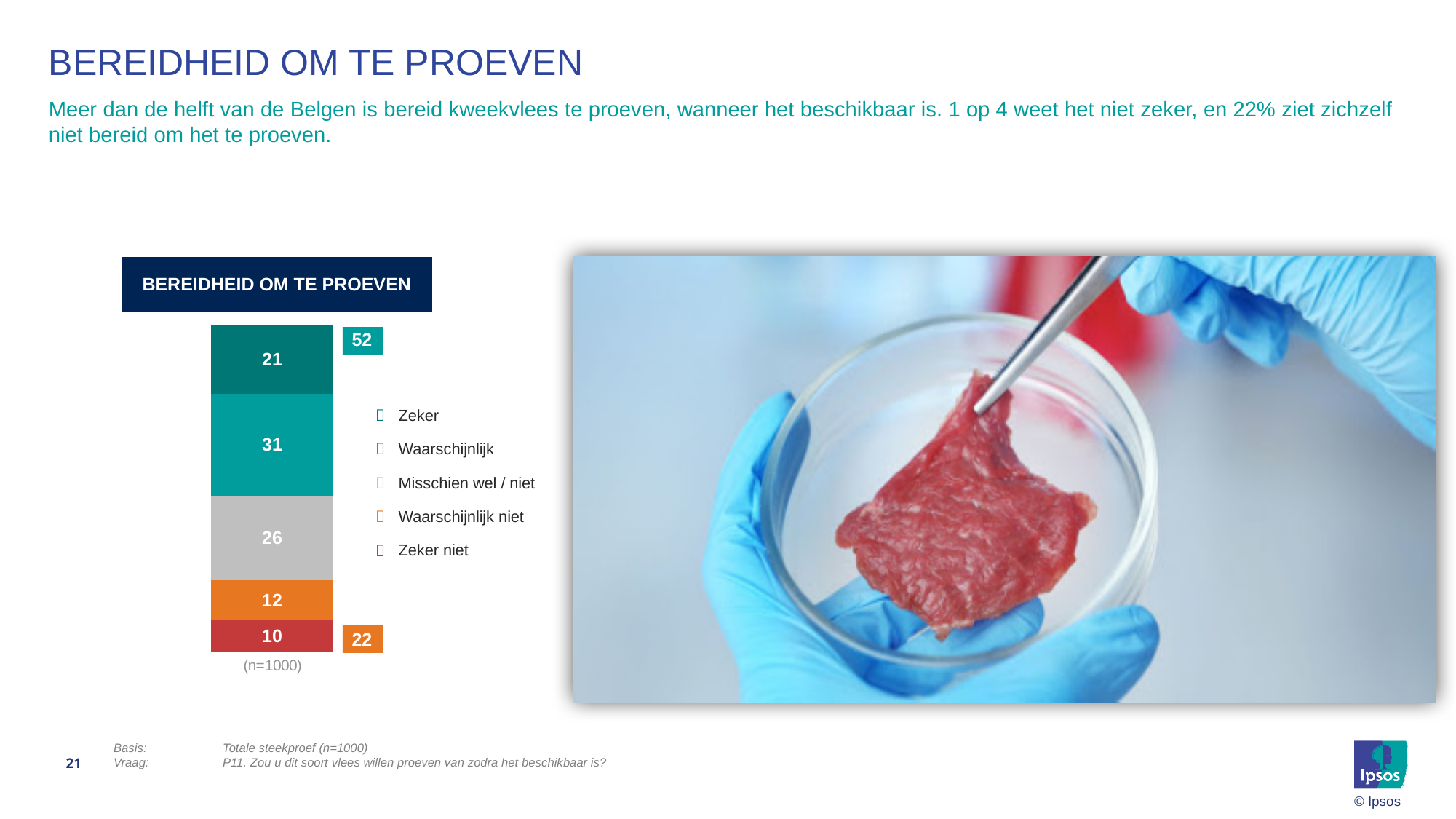
What type of chart is shown on the slide? Stacked bar chart What is the difference between the 'Waarschijnlijk' and 'Zeker' values? 10 What is the total of the stacked bar? 100 What value is shown for the 'Misschien wel / niet' segment? 26 Which segment of the stacked bar has the smallest value? Zeker niet Which is larger, the value for 'Misschien wel / niet' or the value for 'Waarschijnlijk niet'? Misschien wel / niet What value is shown for the 'Waarschijnlijk' segment? 31 What value is shown for the 'Zeker niet' segment? 10 What value is shown for the 'Zeker' segment of the stacked bar? 21 Which segment of the stacked bar has the largest value? Waarschijnlijk How many segments does the stacked bar contain? 5 How many entries does the legend list? 5